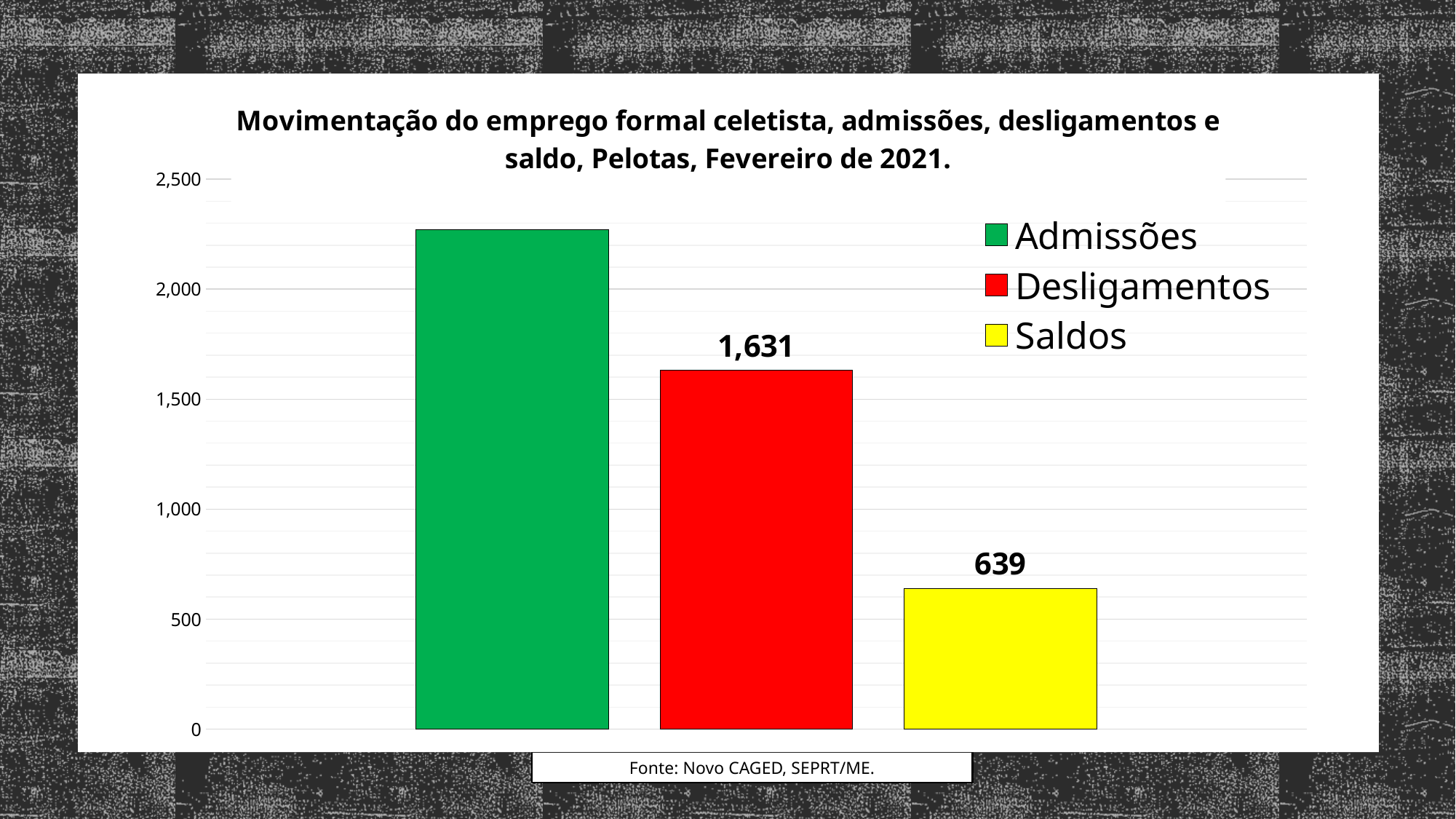
What is the difference between the values for Desligamentos and Saldos? 992 How many bars are plotted in the chart? 3 How many series does the legend list? 3 What is the value for Desligamentos? 1,631 What is the value for Saldos? 639 Which series has the highest bar? Admissões What colour is the bar for Saldos? yellow Is the value for Admissões greater or less than 2,500? less Which is larger, Desligamentos or Saldos? Desligamentos What kind of chart is shown on the slide? bar chart Is the value for Admissões greater or less than 2,000? greater Which series has the lowest bar? Saldos